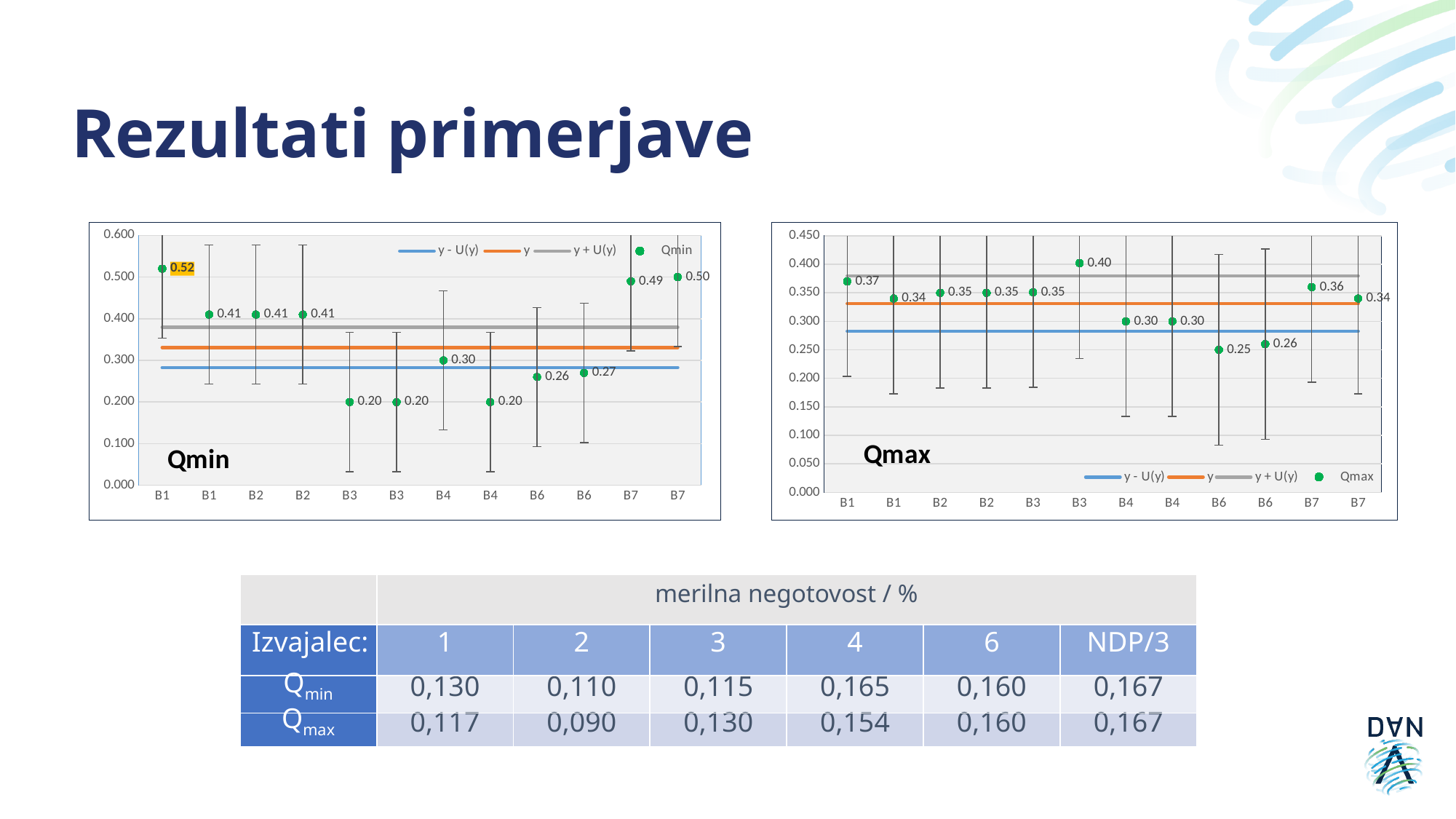
In the Qmin chart, how many entries does the legend list? 4 In the Qmax chart, what is the difference between the second B3 value (0.40) and the first B6 value (0.25)? 0.15 In the Qmin chart, what is the lowest plotted Qmin value? 0.20 In the Qmin chart, what is the difference between the first B1 value (0.52) and the second B7 value (0.50)? 0.02 In the Qmax chart, what is the Qmax value for the first B1 point? 0.37 In the Qmax chart, is the value for the first B6 point greater or less than 0.300? less In the Qmin chart, what is the Qmin value for the first B4 point? 0.30 In the Qmax chart, what is the lowest plotted Qmax value? 0.25 In the Qmin chart, how many Qmin data points are plotted? 12 In the Qmax chart, what is the highest plotted Qmax value? 0.40 In the Qmax chart, which is larger: the second B3 value or the first B4 value? the second B3 value In the Qmin chart, what is the highest plotted Qmin value? 0.52